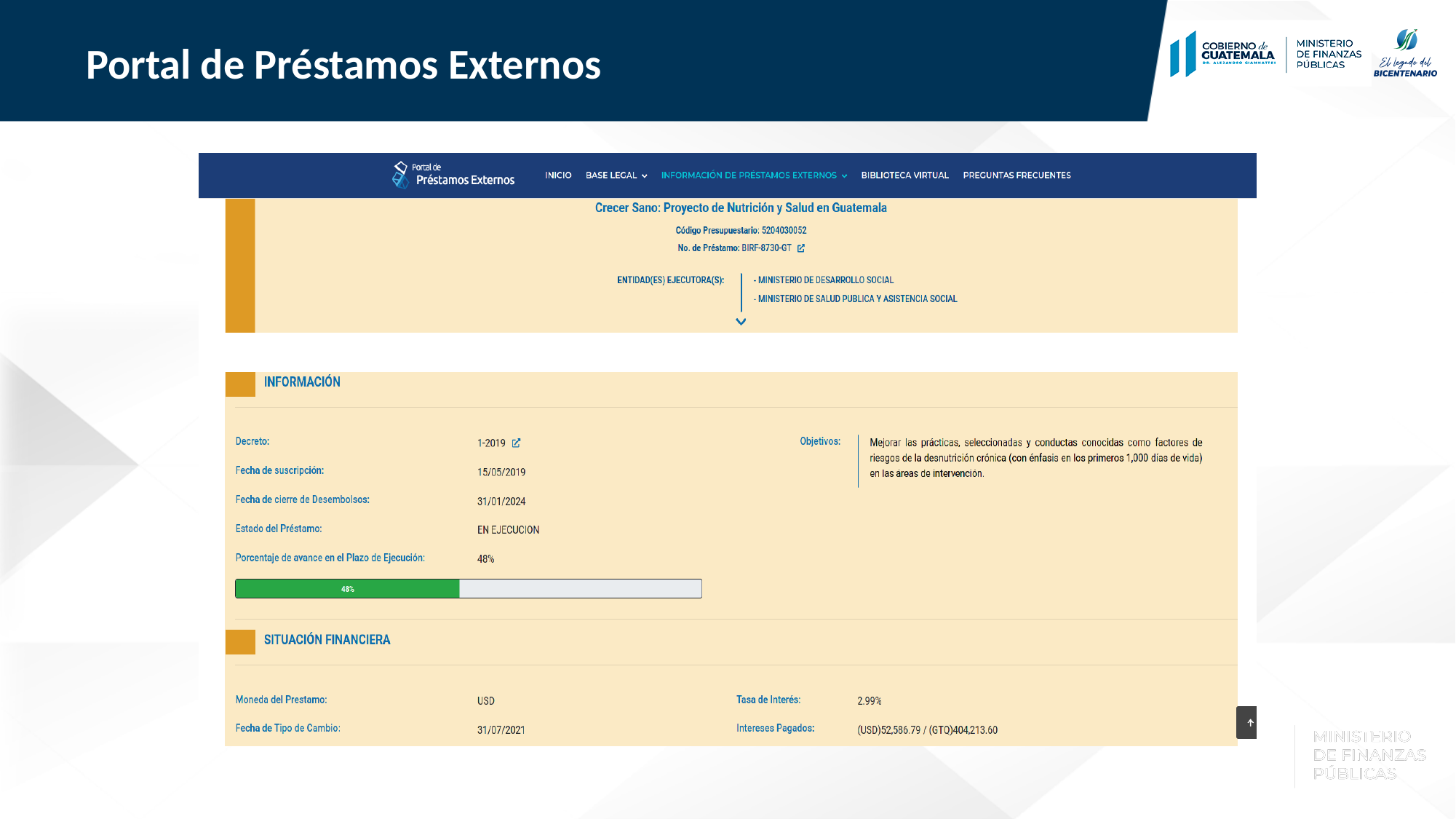
Is the filled portion of the progress bar greater or less than half of the bar? less What value is printed on the green progress bar in the INFORMACIÓN section? 48% What does the progress bar in the INFORMACIÓN section represent, according to the label above it? Porcentaje de avance en el Plazo de Ejecución What colour is the filled portion of the progress bar? Green